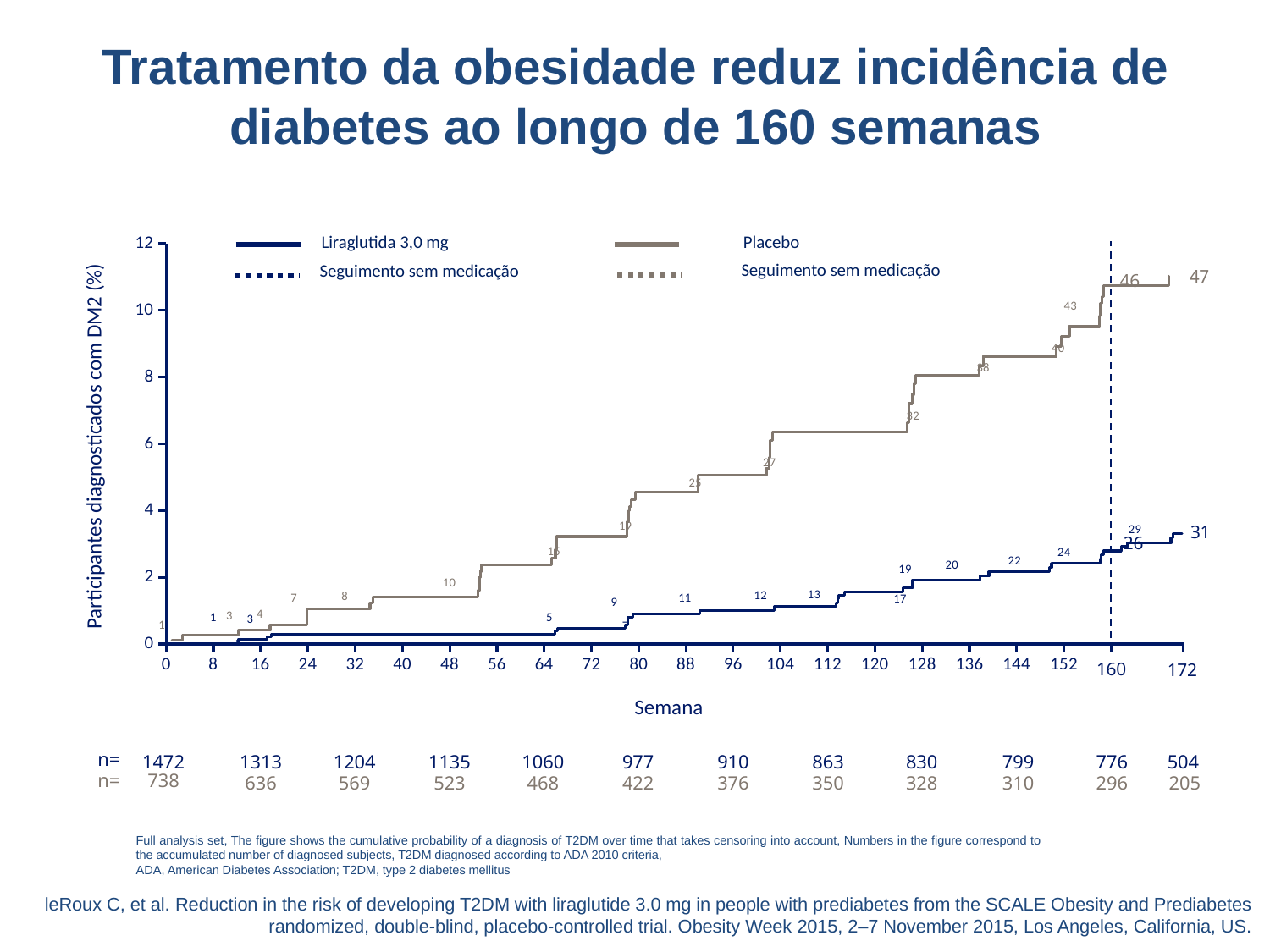
What is the difference between the final accumulated number of diagnosed subjects in the Placebo group (47) and in the Liraglutida 3,0 mg group (31)? 16 Do the curves rise or fall as the weeks increase along the x axis? rise What is the number of participants (n=) in the Liraglutida 3,0 mg group at week 0? 1472 What is the final accumulated number of diagnosed subjects shown at the end of the Liraglutida 3,0 mg curve? 31 Which two treatment groups are plotted in the chart? Liraglutida 3,0 mg and Placebo What is the label of the x axis of the chart? Semana Which group has the higher percentage of participants diagnosed with DM2 at week 160? Placebo What is the number of participants (n=) in the Placebo group at week 0? 738 What kind of chart is shown on the slide? line chart Is the value for the Placebo curve at week 160 greater or less than 10? greater Is the value for the Liraglutida 3,0 mg curve at week 160 greater or less than 4? less What is the final accumulated number of diagnosed subjects shown at the end of the Placebo curve? 47